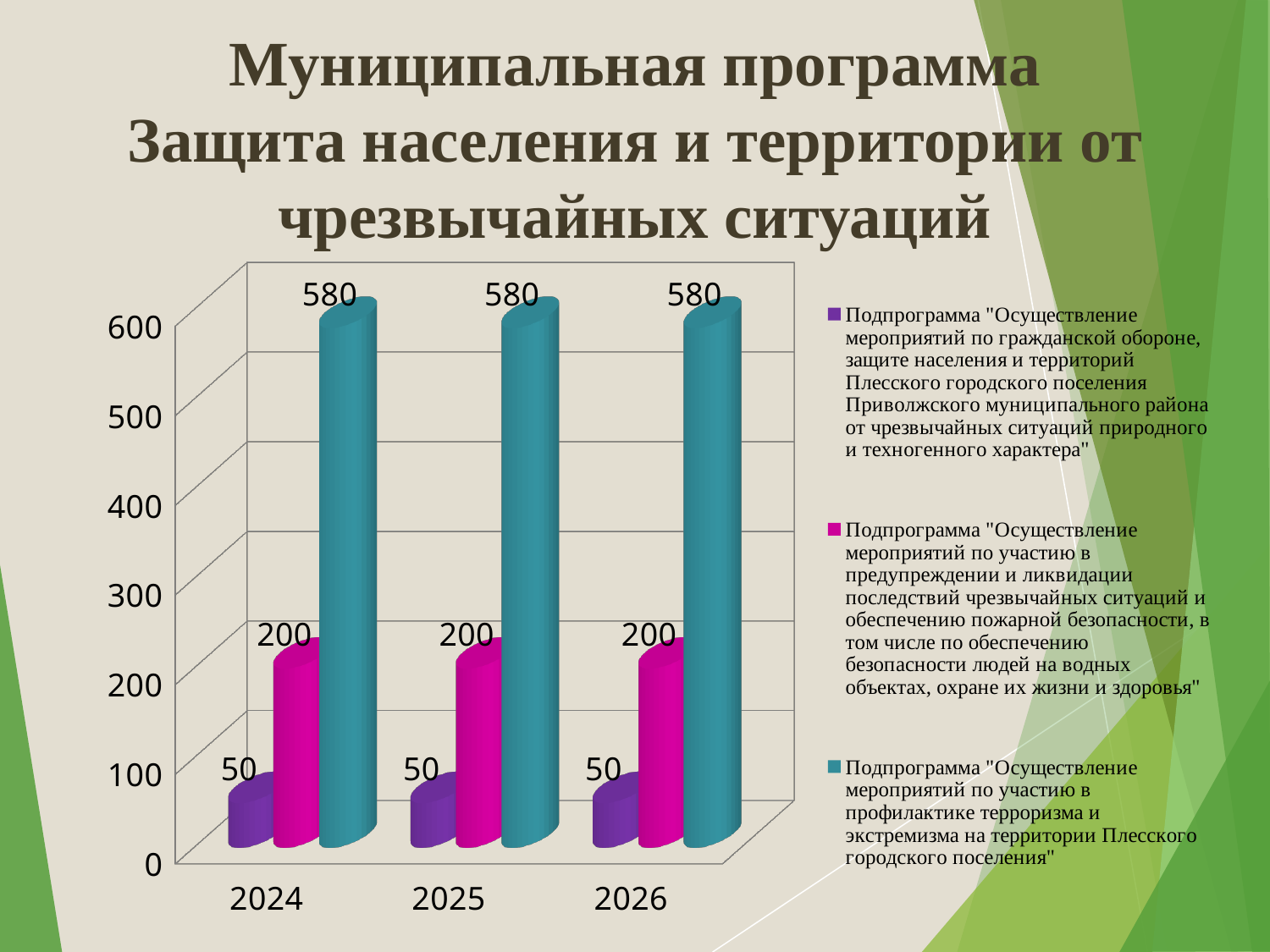
What is the value for 2026 for the subprogramme on emergency prevention and fire safety (magenta bars)? 200 Do the values for the teal series rise, fall or stay the same from 2024 to 2026? Stay the same Which is larger in 2026: the magenta bar or the purple bar? The magenta bar (200) What is the difference between the magenta bar and the purple bar for 2024? 150 How many series does the legend list? 3 What is the difference between the teal bar and the magenta bar for 2025? 380 Which subprogramme has the highest value in 2024? Подпрограмма "Осуществление мероприятий по участию в профилактике терроризма и экстремизма на территории Плесского городского поселения" What kind of chart is shown on the slide? Bar chart What is the value for 2024 for the subprogramme on prevention of terrorism and extremism (teal bars)? 580 How many years are shown on the x axis? 3 What is the value for 2025 for the subprogramme on civil defence and protection from natural and man-made emergencies (purple bars)? 50